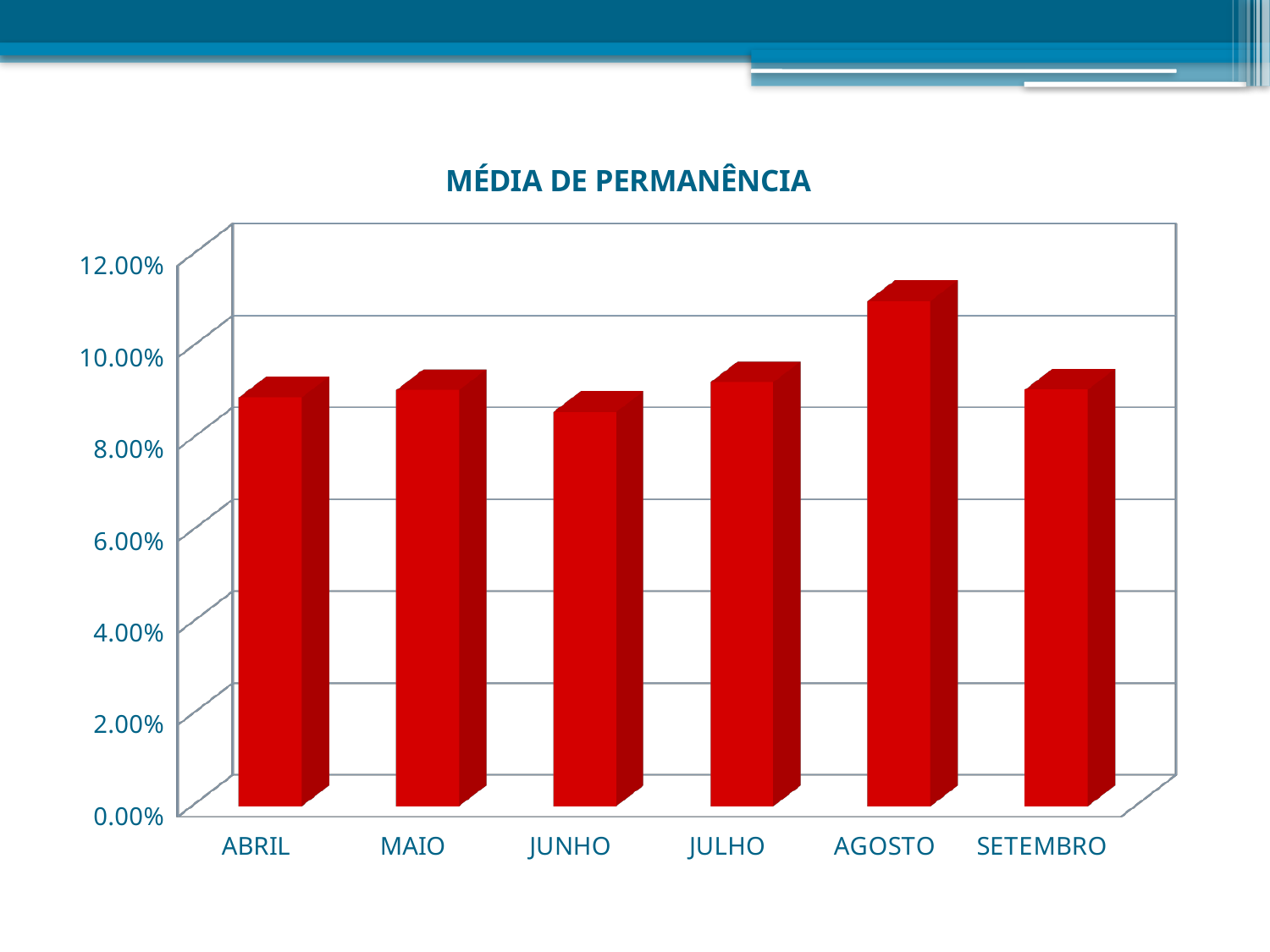
Is the value for JUNHO greater or less than 8.00%? greater Which month has the highest value in the chart? AGOSTO Is the value for JUNHO greater or less than 10.00%? less How many months are shown on the x axis of the chart? 6 Which month has the lowest value in the chart? JUNHO Which is larger, the value for AGOSTO or the value for JULHO? AGOSTO Is the value for ABRIL greater or less than 10.00%? less What kind of chart is shown on the slide? bar chart What colour are the bars in the chart? red What is the title of the chart? MÉDIA DE PERMANÊNCIA Which is larger, the value for JUNHO or the value for JULHO? JULHO